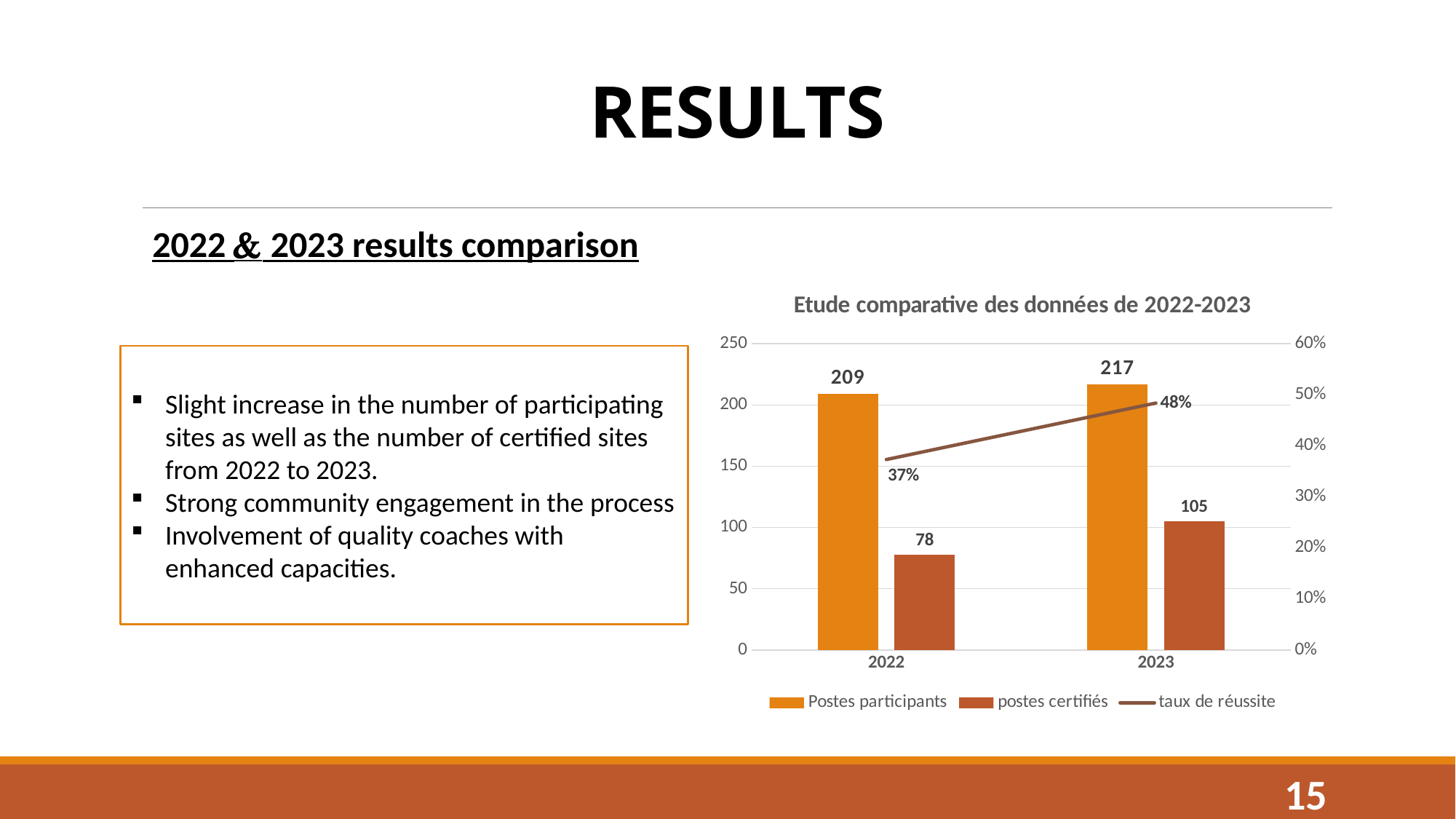
What is the value of postes certifiés for 2023? 105 Is the value for postes certifiés in 2022 greater or less than 100? less What is the taux de réussite for 2022? 37% How many series does the legend list? 3 Does the taux de réussite rise or fall from 2022 to 2023? rise What is the difference in Postes participants between 2023 and 2022? 8 What is the difference in postes certifiés between 2023 and 2022? 27 How many years are shown on the x axis? 2 What is the title of the chart? Etude comparative des données de 2022-2023 What is the value of Postes participants for 2022? 209 What is the taux de réussite for 2023? 48% Which year has the higher value for postes certifiés? 2023